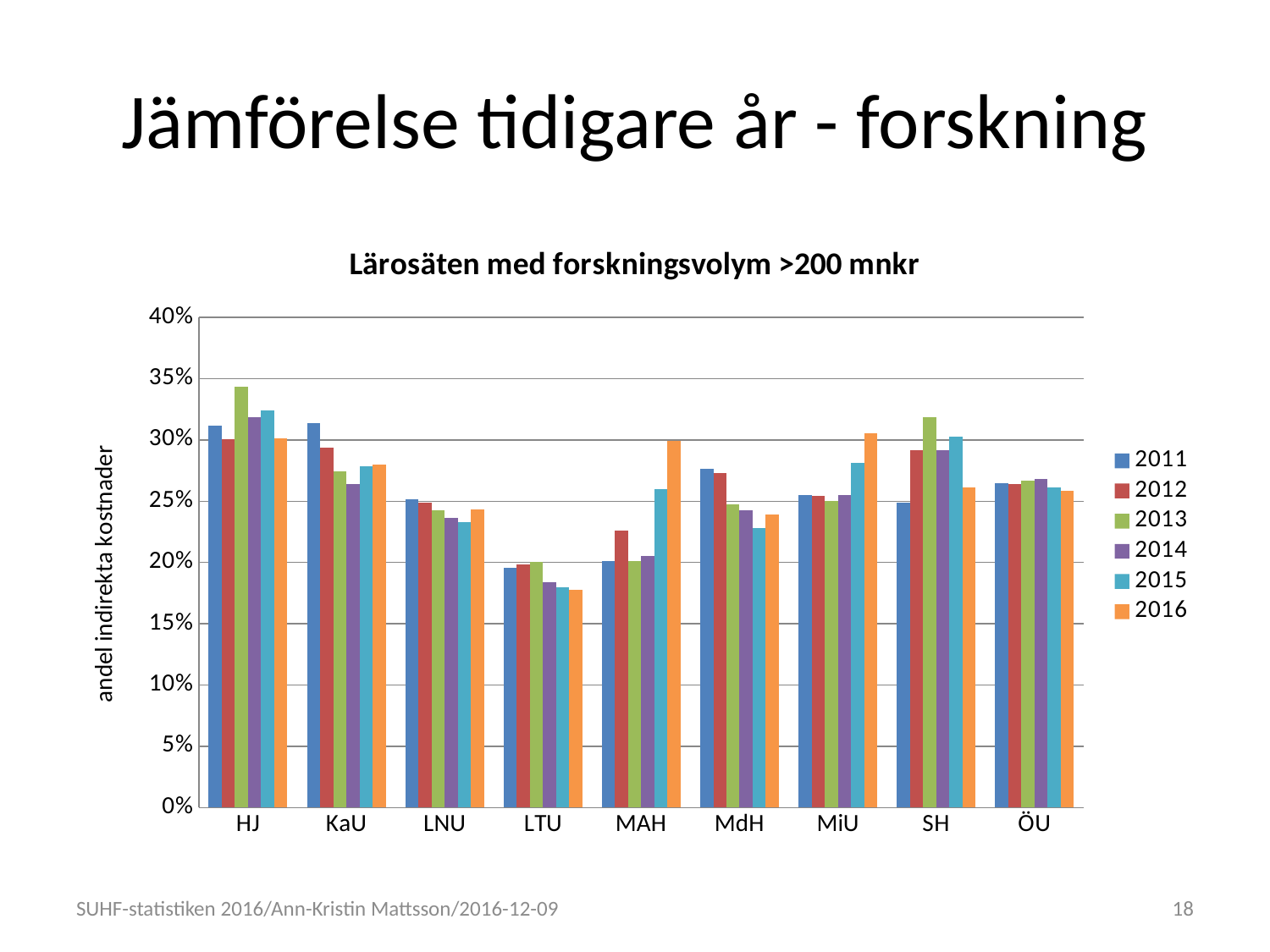
Is the value for LTU in 2016 greater or less than 20%? less Is the value for SH in 2013 greater or less than 30%? greater Which institution has the lowest value for 2016? LTU How many institutions (categories) are shown on the x axis? 9 For MAH, which is larger: the 2011 value or the 2016 value? 2016 How many series does the legend list? 6 What is the title of the chart? Lärosäten med forskningsvolym >200 mnkr Is the value for HJ in 2013 greater or less than 30%? greater Which institution has the highest value for 2013? HJ What kind of chart is shown on the slide? bar chart What is the label on the vertical axis? andel indirekta kostnader